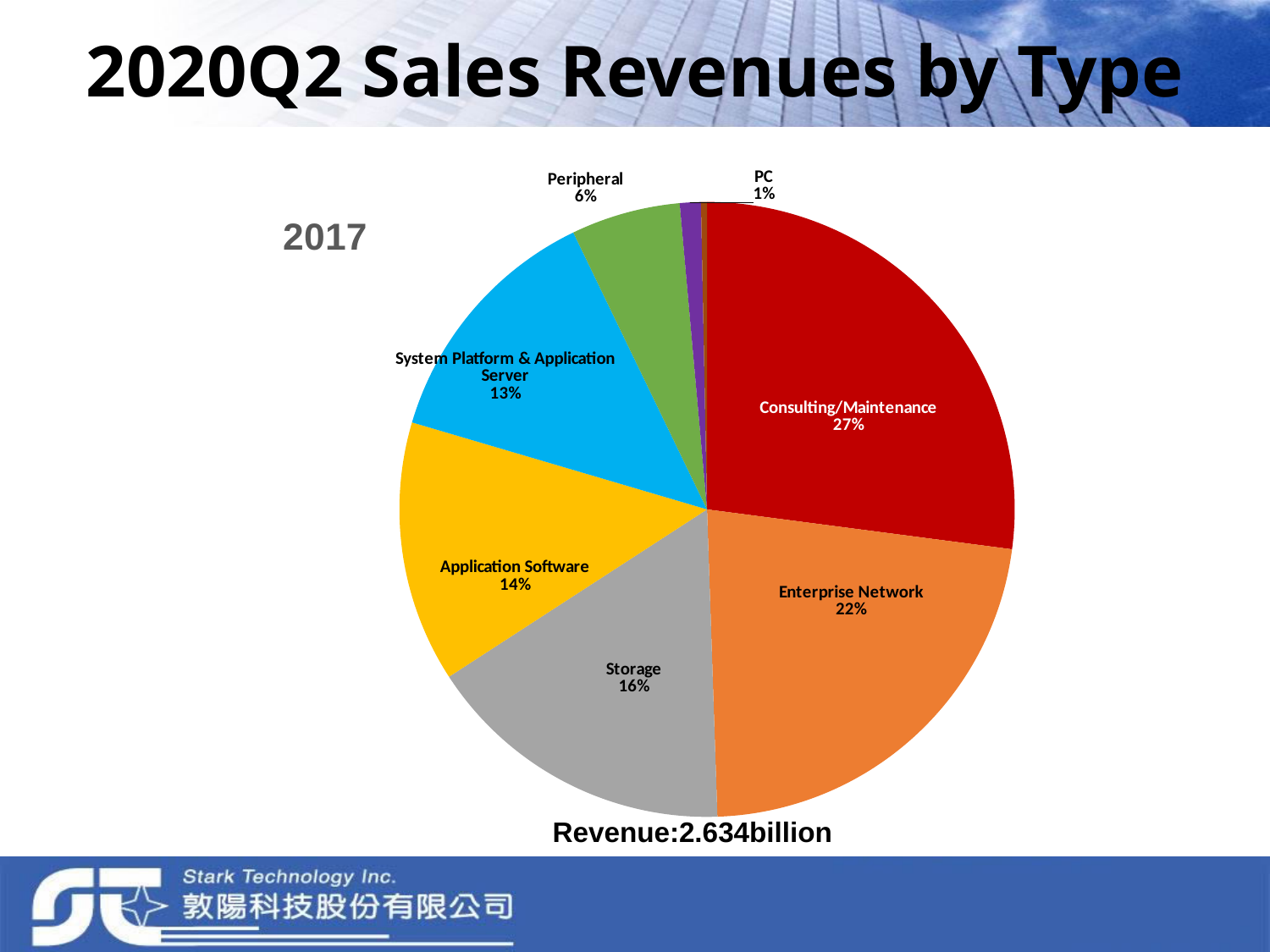
What share of sales revenue does Enterprise Network account for? 22% What percentage is shown for Application Software? 14% What is the difference in percentage points between Consulting/Maintenance and Enterprise Network? 5 Which labeled category has the smallest share of the pie? PC Which labeled category has the largest share of the pie? Consulting/Maintenance What percentage is shown for System Platform & Application Server? 13% Which has a larger share, Storage or Application Software? Storage What kind of chart is shown on the slide? pie chart What percentage is shown for Peripheral? 6% What total revenue figure is printed below the pie chart? Revenue:2.634billion What percentage is shown for Storage? 16% What share of sales revenue does Consulting/Maintenance account for? 27%